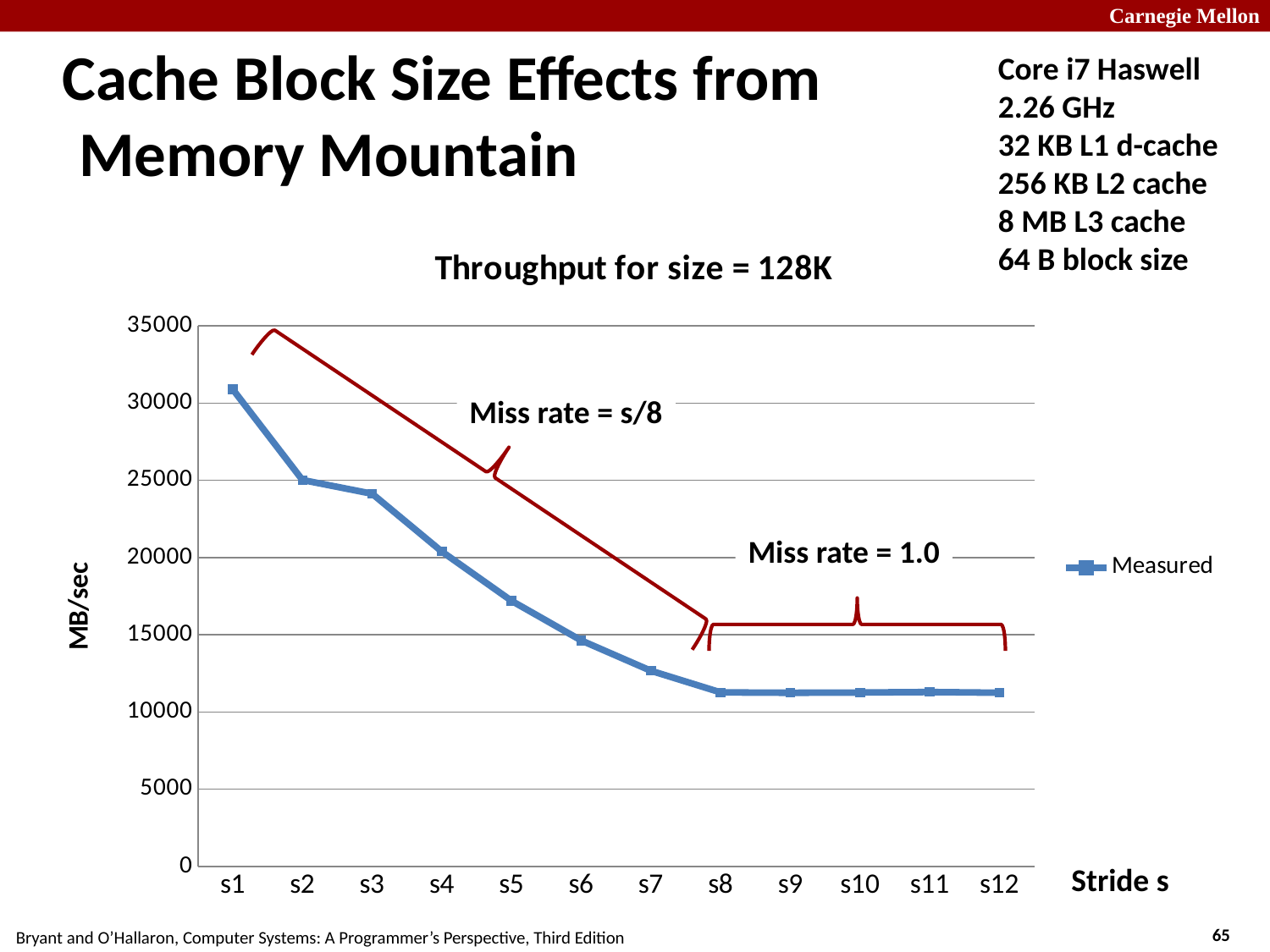
What is the label on the y axis of the chart? MB/sec Is the measured value for s7 greater or less than 15000? less Do the measured throughput values rise or fall as the stride increases from s1 to s8? fall Is the measured value for s10 greater or less than 10000? greater What is the title of the chart? Throughput for size = 128K How many series does the legend list? 1 Which has the larger measured throughput, s2 or s5? s2 What kind of chart is shown on the slide? line chart Is the measured value for s1 greater or less than 30000? greater How many stride categories are plotted along the x axis? 12 Which stride has the highest measured throughput? s1